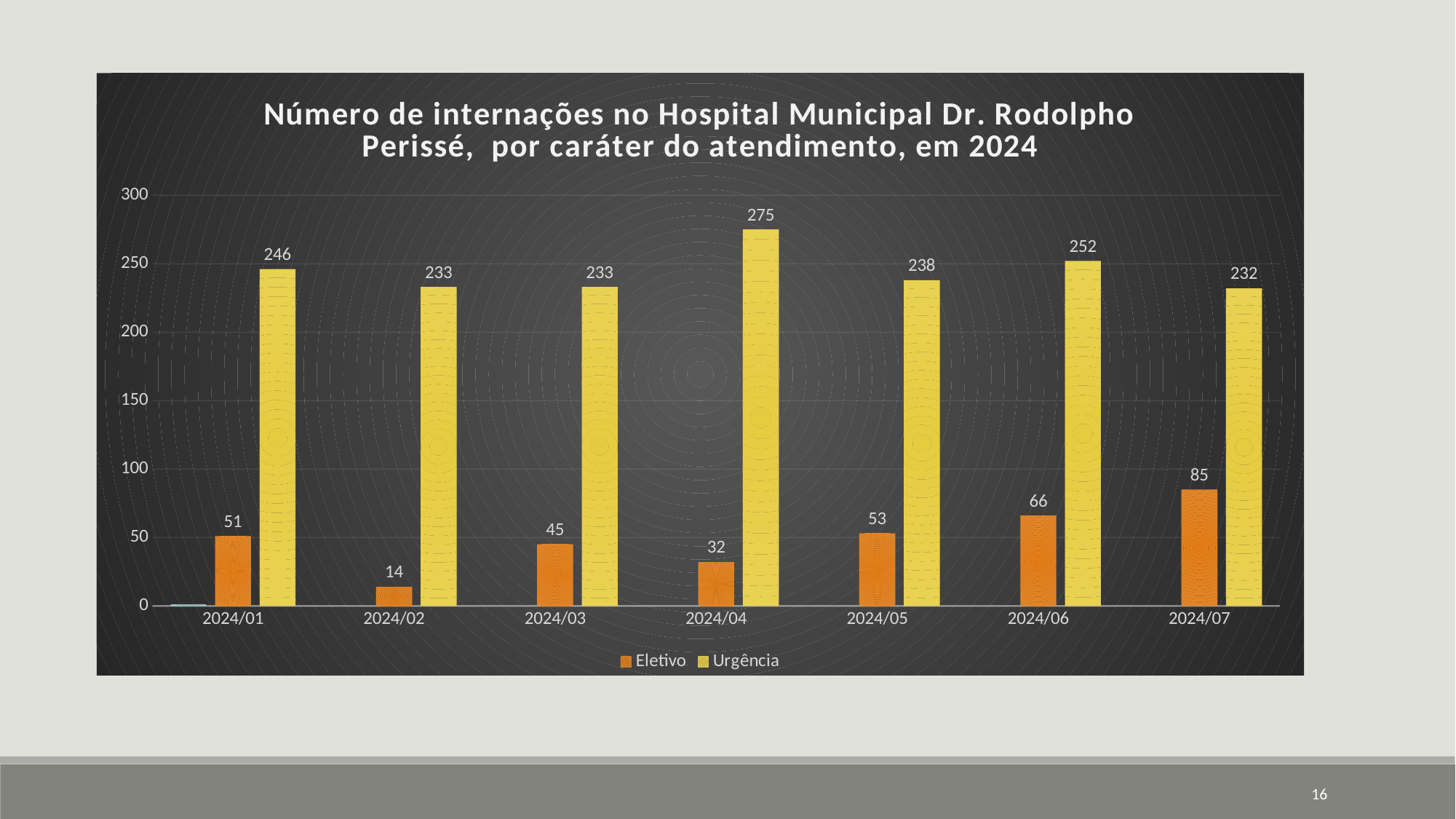
What colour are the Urgência bars? yellow Which is larger, the Eletivo value for 2024/05 or the Eletivo value for 2024/03? 2024/05 Which month has the highest Eletivo value? 2024/07 How many series does the legend list? 2 What is the Eletivo value for 2024/02? 14 Is the Urgência value for 2024/01 greater or less than 200? greater What is the difference between the Urgência and Eletivo values for 2024/06? 186 How many months are shown on the x axis? 7 Which month has the lowest Urgência value? 2024/07 Do the Eletivo values rise or fall from 2024/04 to 2024/07? rise What is the Urgência value for 2024/04? 275 What kind of chart is shown on the slide? bar chart